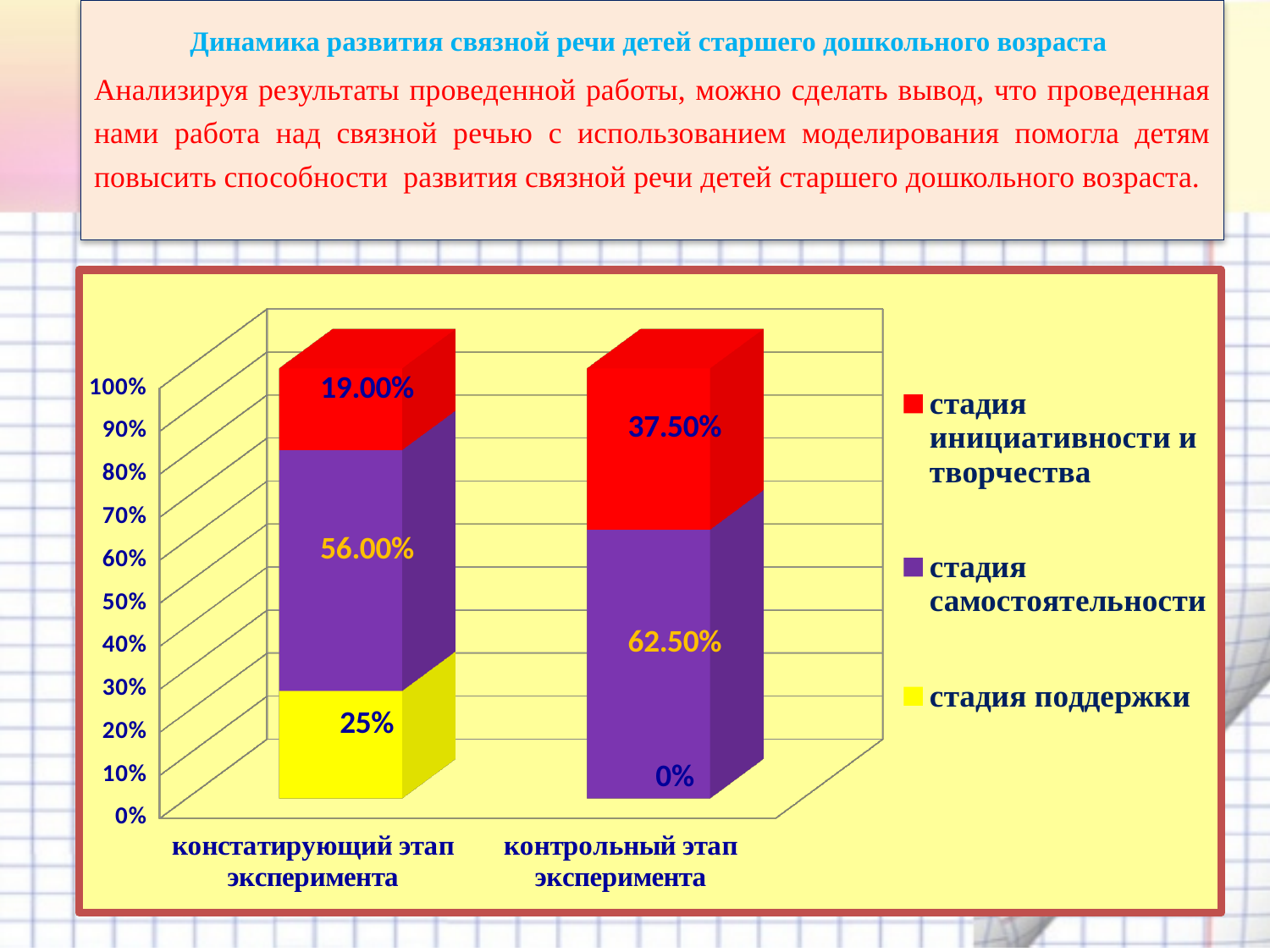
How many categories are shown on the x axis? 2 How many series does the legend list? 3 What is the value for "стадия самостоятельности" at the "констатирующий этап эксперимента"? 56.00% Which series has the lowest value at the "констатирующий этап эксперимента"? стадия инициативности и творчества What is the difference between the "стадия инициативности и творчества" values at the "контрольный этап эксперимента" and the "констатирующий этап эксперимента"? 18.50% What is the value for "стадия поддержки" at the "констатирующий этап эксперимента"? 25% Which colour represents "стадия поддержки" in the legend? Yellow Which series has the highest value at the "контрольный этап эксперимента"? стадия самостоятельности Which is larger: the "стадия самостоятельности" value at the "констатирующий этап эксперимента" or at the "контрольный этап эксперимента"? контрольный этап эксперимента What is the value for "стадия инициативности и творчества" at the "контрольный этап эксперимента"? 37.50% What kind of chart is shown on the slide? Stacked bar chart What is the value for "стадия поддержки" at the "контрольный этап эксперимента"? 0%